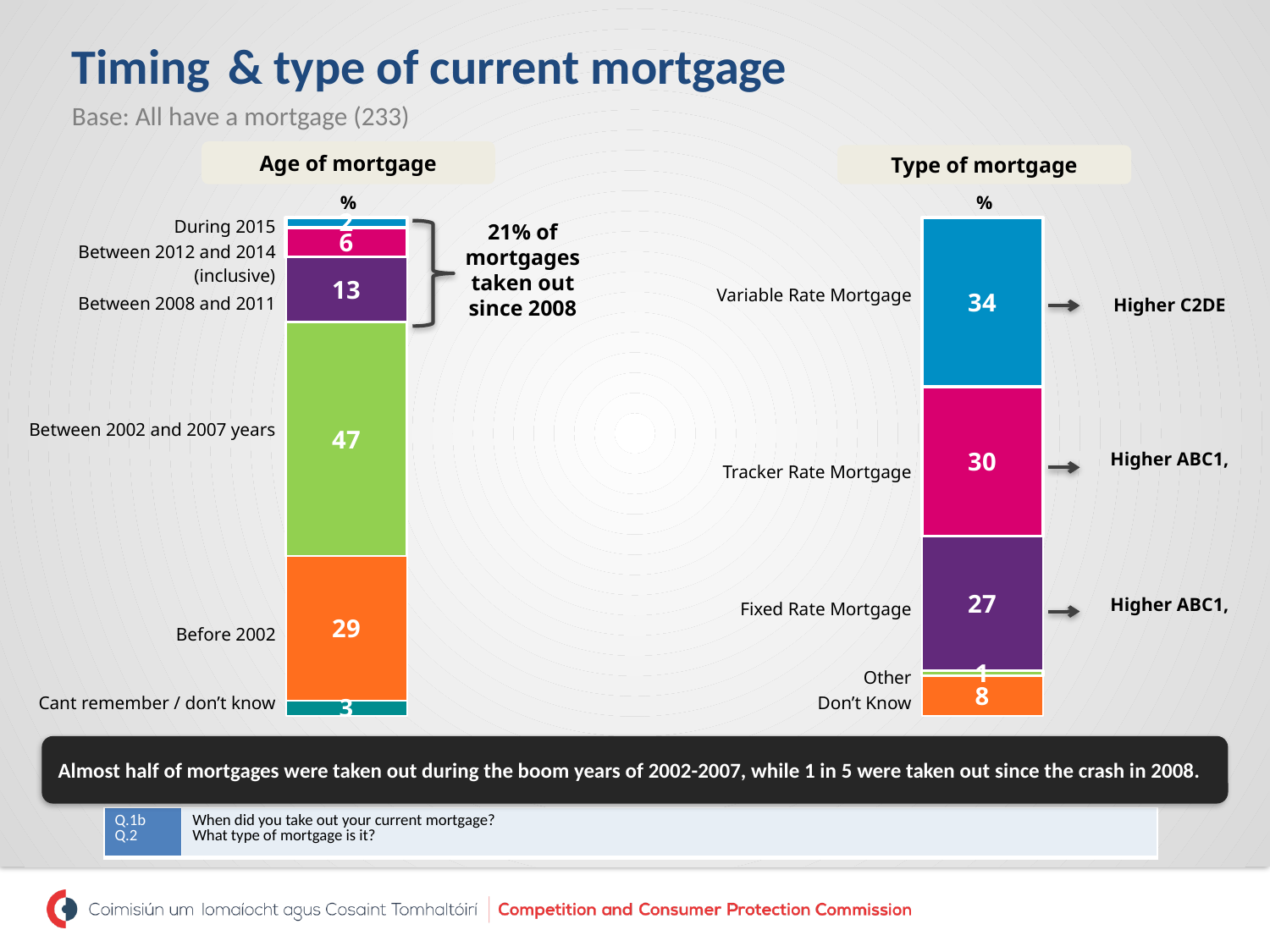
In the Type of mortgage chart, which mortgage type has the highest value? Variable Rate Mortgage In the Age of mortgage chart, what percentage of mortgages were taken out before 2002? 29 According to the annotation on the Age of mortgage chart, what percentage of mortgages were taken out since 2008? 21% In the Age of mortgage chart, which is larger: Between 2012 and 2014 (inclusive) or Between 2008 and 2011? Between 2008 and 2011 What kind of chart is the Type of mortgage chart? Stacked bar chart In the Type of mortgage chart, what is the difference between Tracker Rate Mortgage and Fixed Rate Mortgage? 3 In the Age of mortgage chart, what percentage of mortgages were taken out between 2002 and 2007? 47 In the Age of mortgage chart, which category has the highest value? Between 2002 and 2007 years In the Age of mortgage chart, what is the difference between the Between 2002 and 2007 value and the Before 2002 value? 18 In the Type of mortgage chart, what percentage have a Fixed Rate Mortgage? 27 In the Age of mortgage chart, what is the value for Between 2008 and 2011? 13 In the Type of mortgage chart, what percentage have a Variable Rate Mortgage? 34